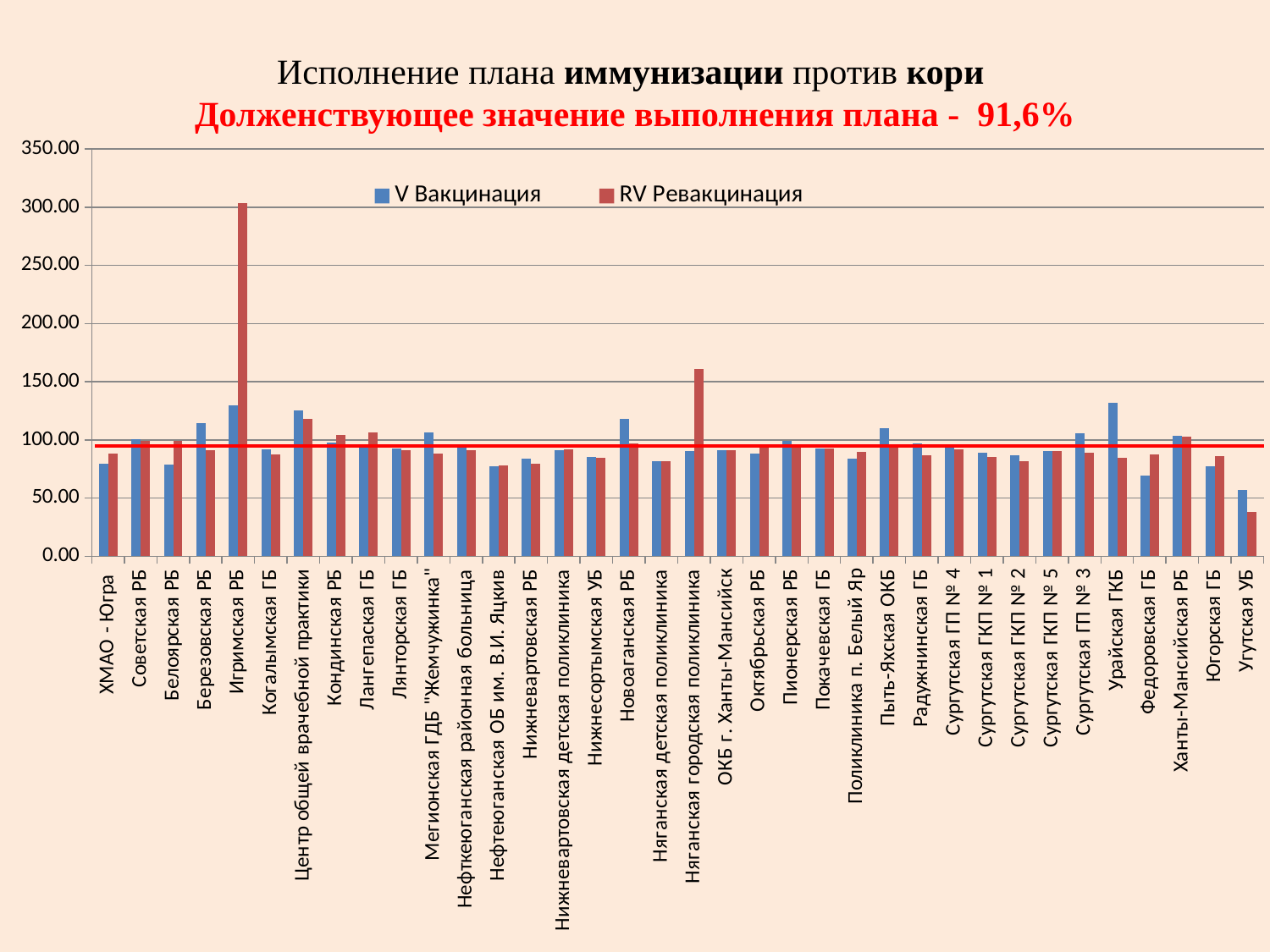
Is the RV Ревакцинация value for Няганская городская поликлиника greater or less than 150? greater For Урайская ГКБ, which is larger: V Вакцинация or RV Ревакцинация? V Вакцинация How many categories (institutions) are shown on the x axis? 36 Is the RV Ревакцинация value for Игримская РБ greater or less than 250? greater Which category has the lowest V Вакцинация value? Угутская УБ Is the V Вакцинация value for Федоровская ГБ greater or less than 100? less What kind of chart is shown on the slide? bar chart How many series does the legend list? 2 Which category has the highest RV Ревакцинация value? Игримская РБ Which category has the lowest RV Ревакцинация value? Угутская УБ For Игримская РБ, which is larger: V Вакцинация or RV Ревакцинация? RV Ревакцинация What target value for plan fulfilment is stated in the red subtitle? 91,6%